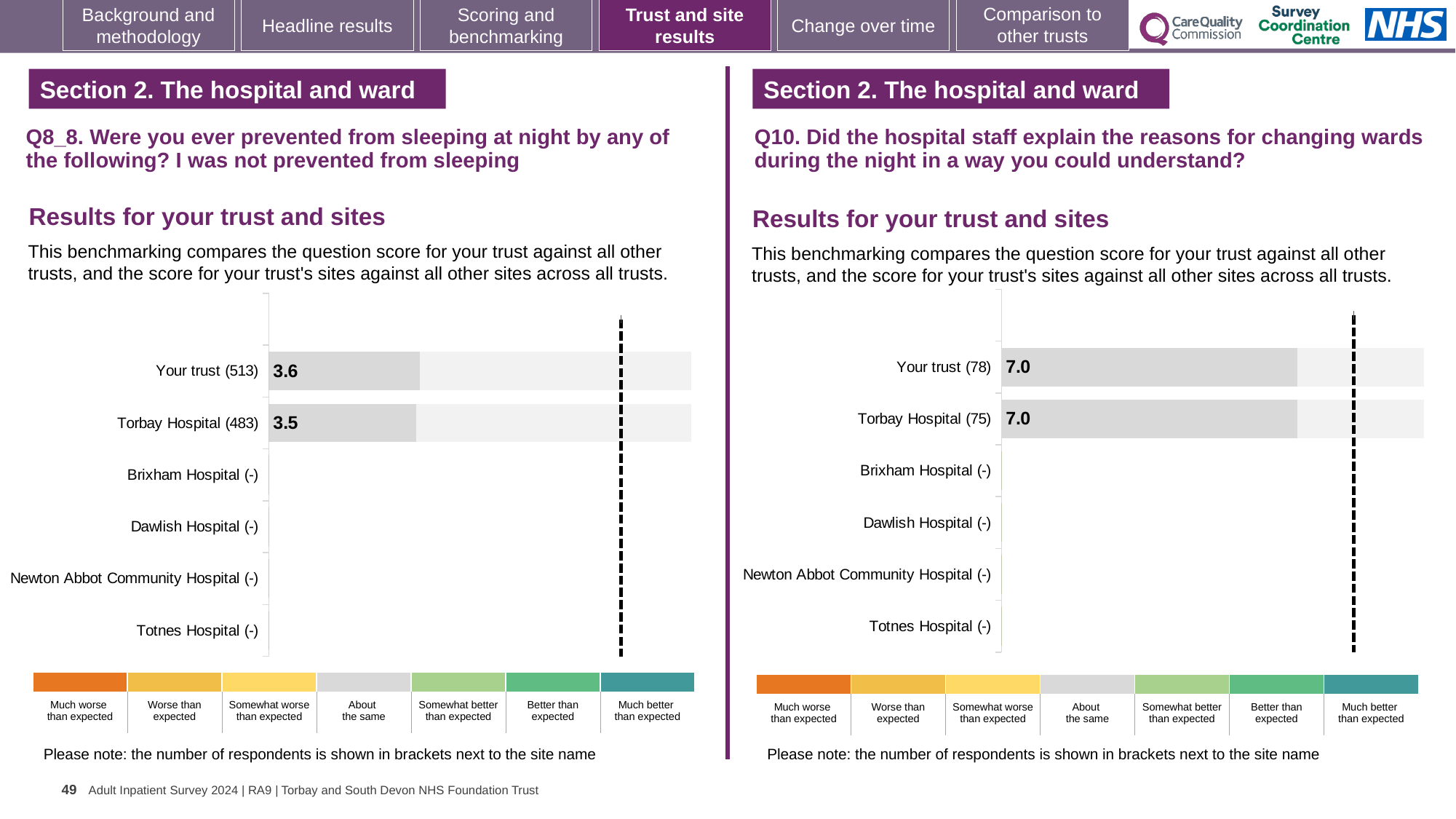
In the left chart (Q8_8), which category has the higher score, Your trust or Torbay Hospital? Your trust In the left chart (Q8_8), what is the difference between the score for Your trust and the score for Torbay Hospital? 0.1 In the right chart (Q10), what is the score for Torbay Hospital? 7.0 In the right chart (Q10), how many respondents are shown in brackets for Torbay Hospital? 75 In the left chart (Q8_8), how many respondents are shown in brackets for Your trust? 513 In the left chart (Q8_8), how many categories have a plotted bar with a value? 2 In the right chart (Q10), what is the difference between the score for Your trust and the score for Torbay Hospital? 0.0 In the left chart (Q8_8), what is the score for Your trust? 3.6 How many site/trust categories are listed on the y axis of the left chart (Q8_8)? 6 In the right chart (Q10), what is the score for Your trust? 7.0 In the left chart (Q8_8), what is the score for Torbay Hospital? 3.5 What kind of chart is used in the right chart (Q10)? Bar chart